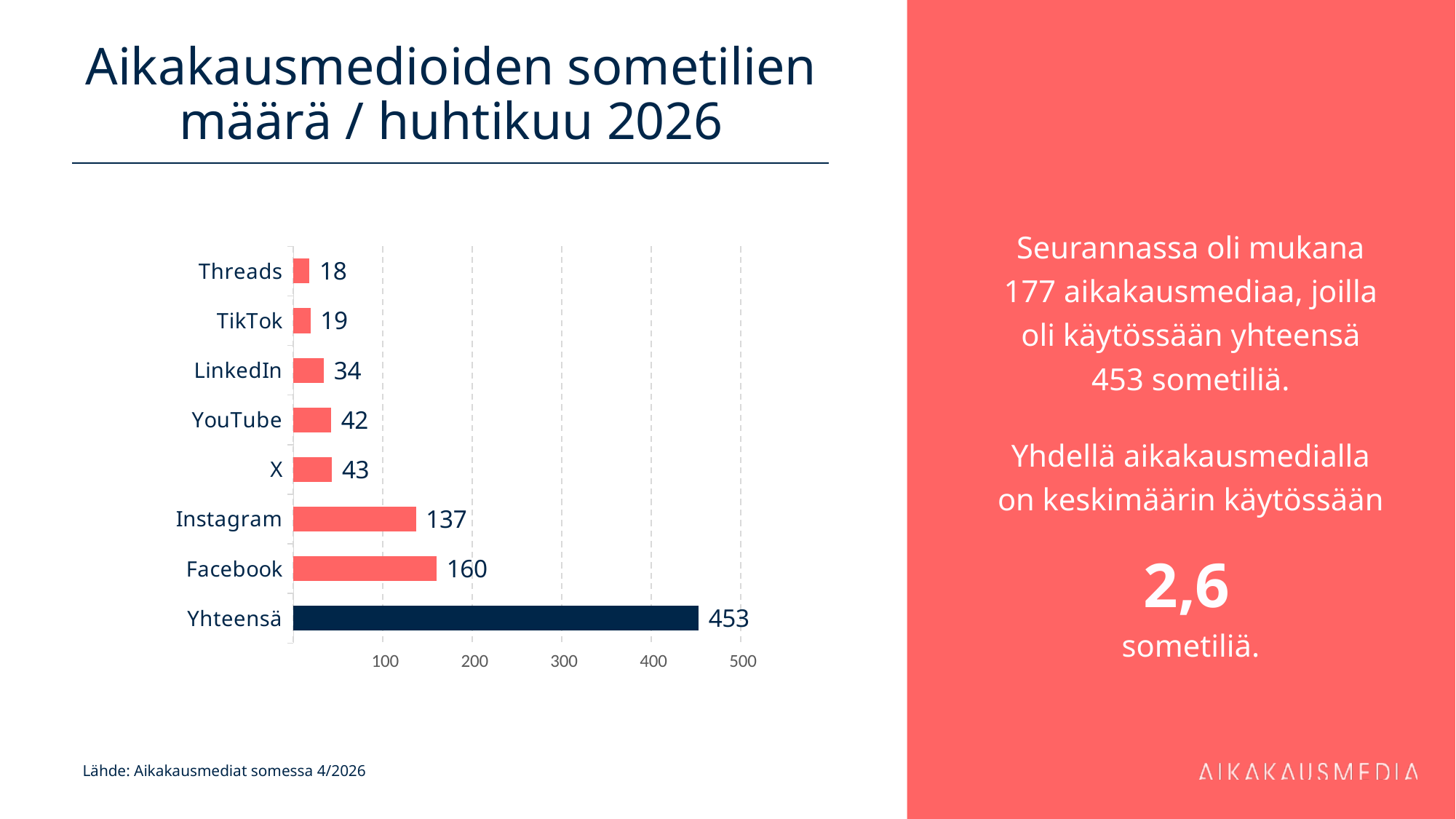
Which platform has the lowest value? Threads What is the value for LinkedIn? 34 What is the value for Facebook? 160 What is the difference between the values for Facebook and Instagram? 23 What is the value for Instagram? 137 Excluding the Yhteensä total bar, which platform has the highest value? Facebook What is the value shown for Yhteensä? 453 How many bars are shown in the chart, including Yhteensä? 8 What kind of chart is shown on the slide? Bar chart Which is larger, the value for X or the value for TikTok? X What colour is the Yhteensä bar compared with the other bars? Dark navy; the others are coral red What is the difference between the values for YouTube and LinkedIn? 8